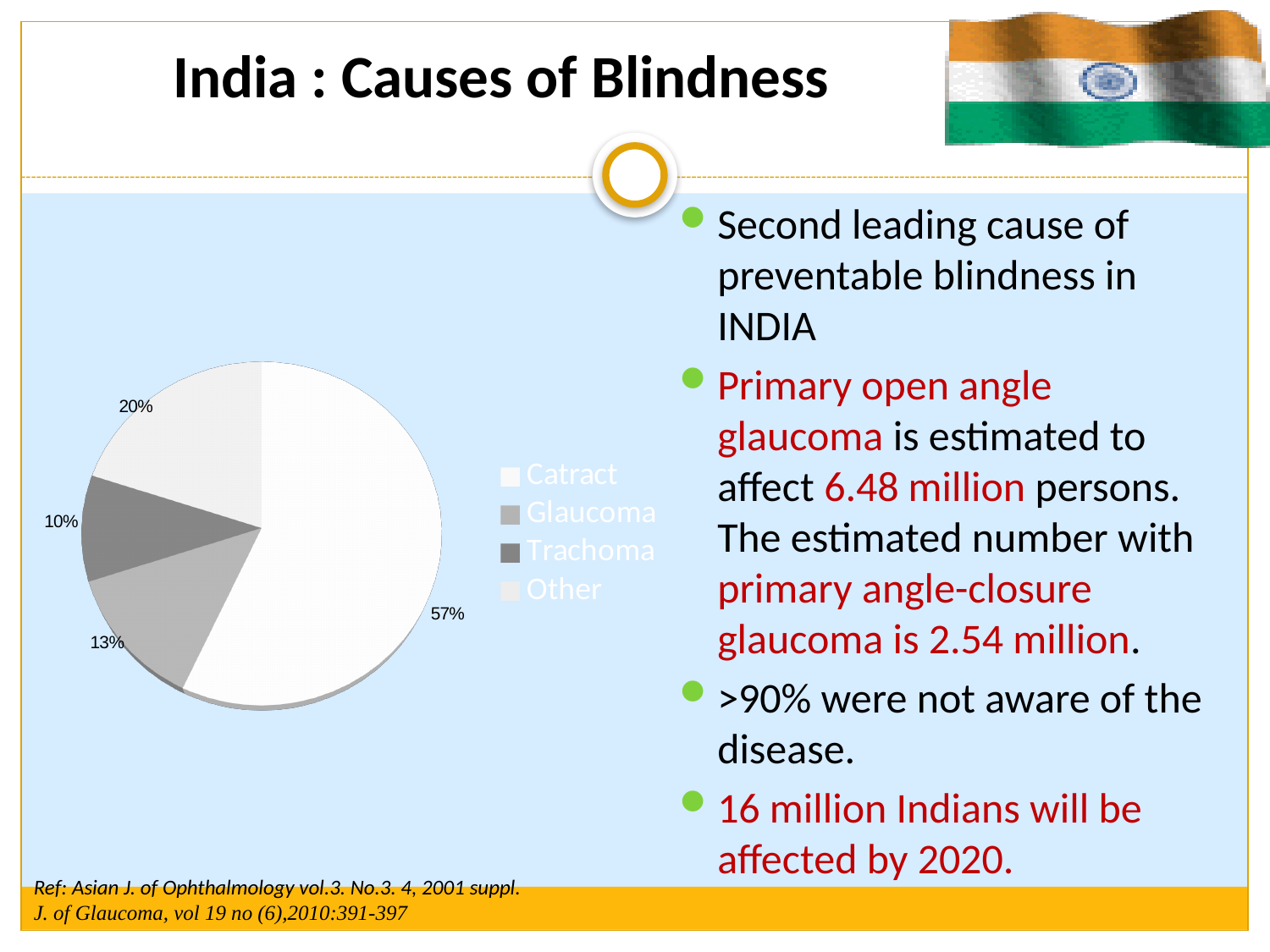
Which cause of blindness has the largest share of the pie? Catract What is the combined percentage of the Glaucoma and Trachoma slices? 23% What percentage of blindness is attributed to Trachoma? 10% Which is larger, the Glaucoma slice or the Trachoma slice? Glaucoma How many slices does the pie chart have? 4 How many entries does the legend list? 4 What percentage of blindness is attributed to Glaucoma? 13% What percentage of blindness is attributed to Catract? 57% Which cause of blindness has the smallest share of the pie? Trachoma What percentage of blindness is attributed to Other causes? 20% What is the difference in percentage points between the Catract slice and the Other slice? 37 What type of chart is shown on the slide? pie chart